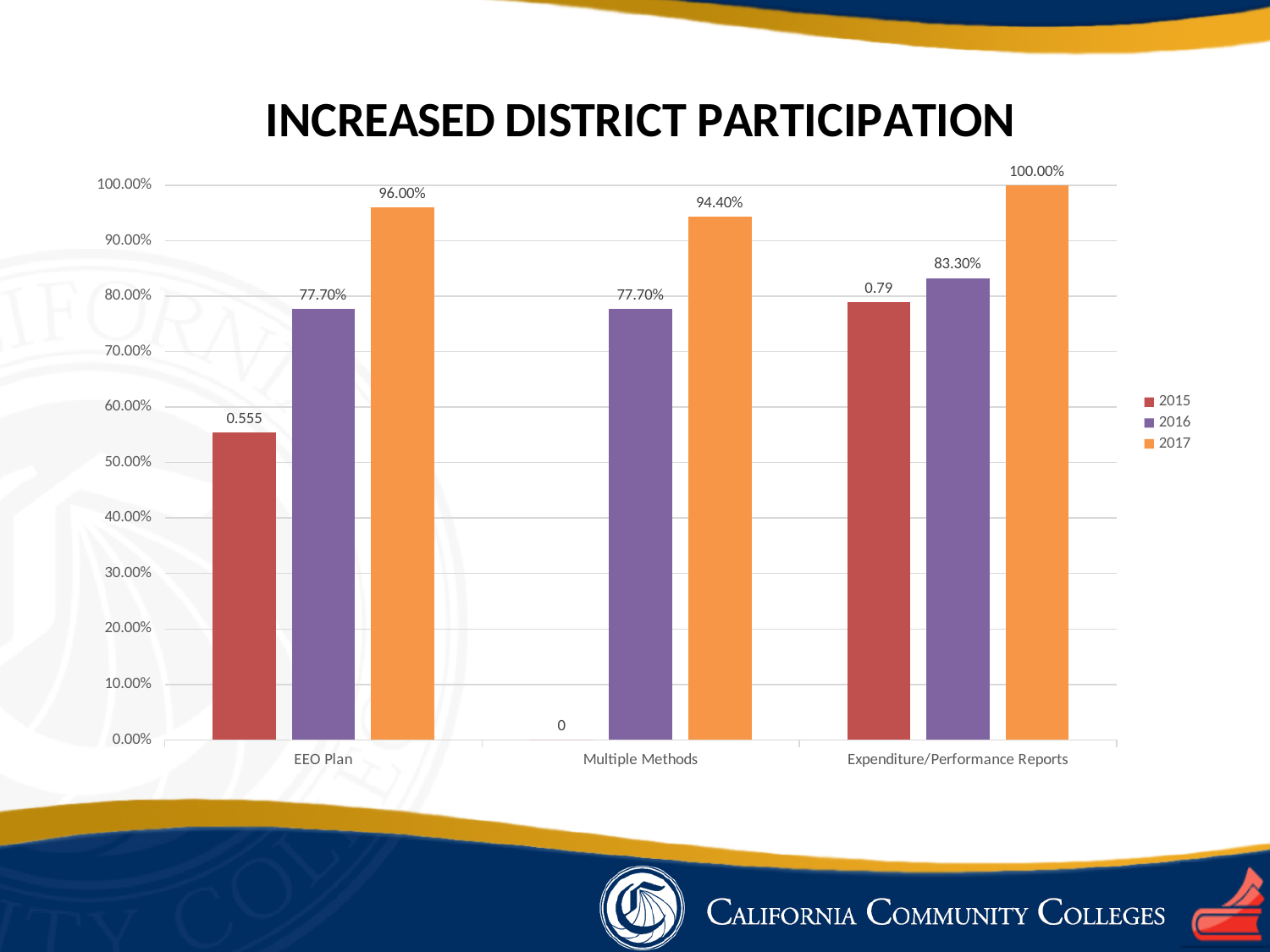
What is the difference between the 2017 and 2016 values in the Expenditure/Performance Reports category? 16.70% Which category has the lowest value for the 2015 series? Multiple Methods What is the value for 2017 in the EEO Plan category? 96.00% What is the data label shown for 2015 in the Multiple Methods category? 0 What is the data label shown for 2015 in the EEO Plan category? 0.555 How many categories are shown on the x axis? 3 What is the value for 2016 in the Expenditure/Performance Reports category? 83.30% What kind of chart is shown on the slide? Bar chart How many series does the legend list? 3 Which category has the highest value for the 2017 series? Expenditure/Performance Reports Which is larger: the 2017 value for EEO Plan or the 2017 value for Multiple Methods? EEO Plan What is the title of the chart? INCREASED DISTRICT PARTICIPATION